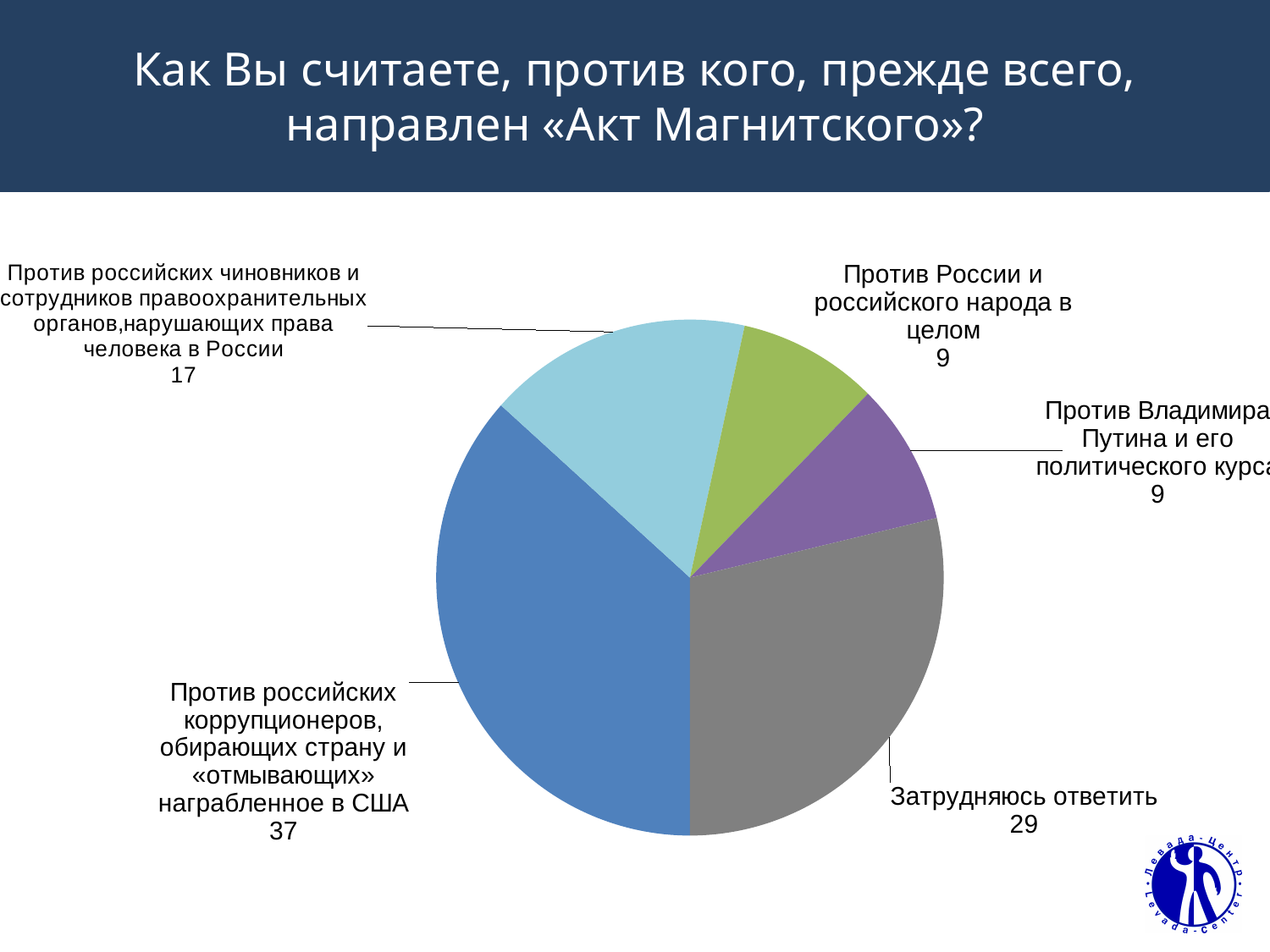
What kind of chart is shown on the slide? pie chart What is the difference between the value for «Затрудняюсь ответить» and the value for «Против российских чиновников и сотрудников правоохранительных органов, нарушающих права человека в России»? 12 What is the value for «Против российских коррупционеров, обирающих страну и «отмывающих» награбленное в США»? 37 How many slices does the pie chart have? 5 What is the value for «Против Владимира Путина и его политического курса»? 9 What is the value for «Затрудняюсь ответить»? 29 Which is larger: the value for «Затрудняюсь ответить» or the value for «Против России и российского народа в целом»? Затрудняюсь ответить Which category has the largest slice of the pie? Против российских коррупционеров, обирающих страну и «отмывающих» награбленное в США What is the value for «Против российских чиновников и сотрудников правоохранительных органов, нарушающих права человека в России»? 17 What is the difference between the value for «Против российских коррупционеров, обирающих страну и «отмывающих» награбленное в США» and the value for «Затрудняюсь ответить»? 8 What is the title of the chart on the slide? Как Вы считаете, против кого, прежде всего, направлен «Акт Магнитского»? What is the value for «Против России и российского народа в целом»? 9